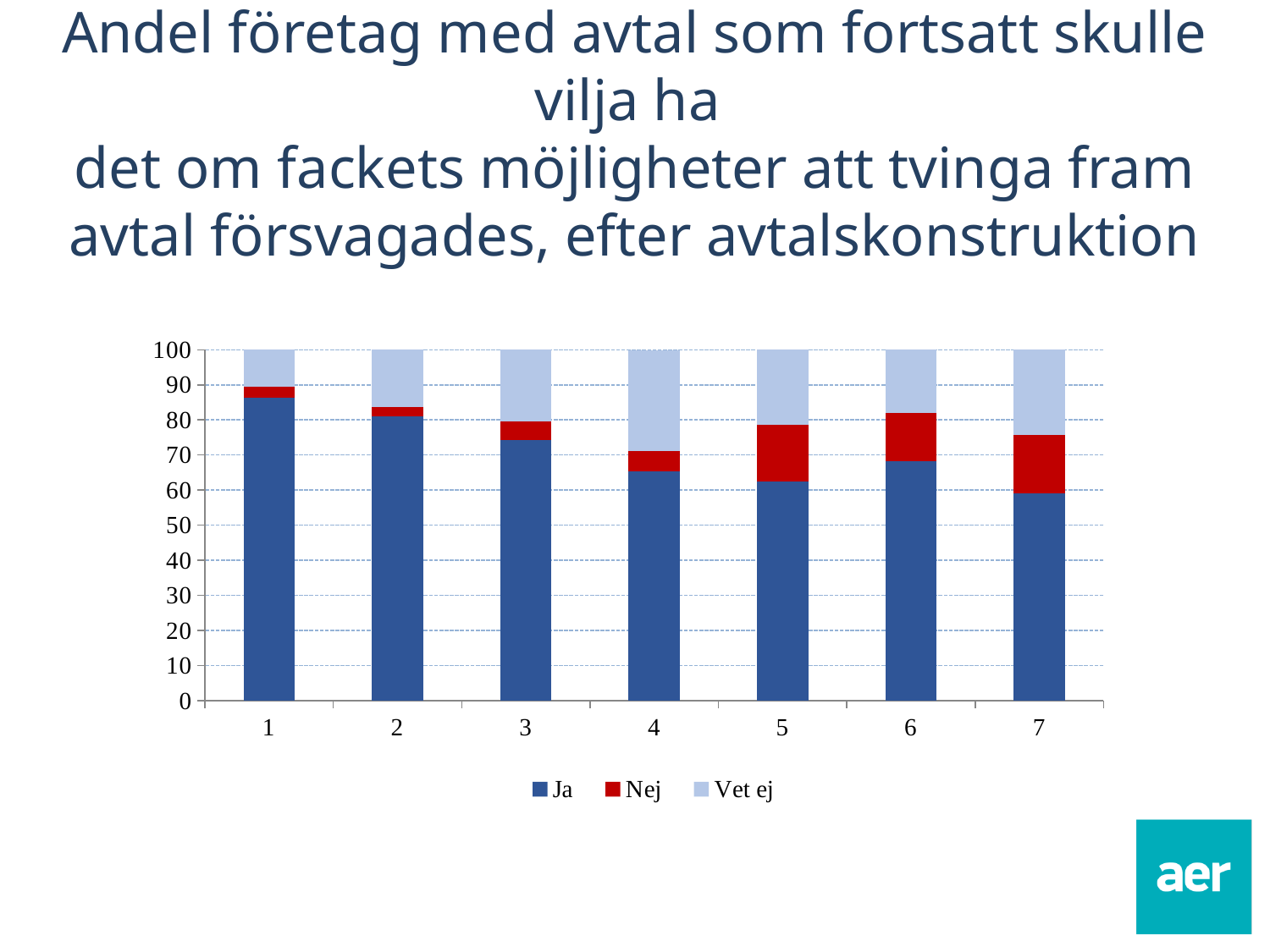
Which category has the highest value for the 'Ja' series? 1 How many series does the chart's legend list? 3 Is the 'Ja' value for category 4 greater or less than 70? less What kind of chart is shown on the slide? stacked bar chart Which is larger, the 'Ja' value for category 2 or for category 5? category 2 Is the 'Ja' value for category 1 greater or less than 80? greater Which colour represents the 'Ja' series in the chart? dark blue How many categories are shown on the x axis of the chart? 7 Which category has the lowest value for the 'Ja' series? 7 What is the total height of the stacked bar for category 3? 100 What are the series names listed in the chart's legend? Ja, Nej, Vet ej